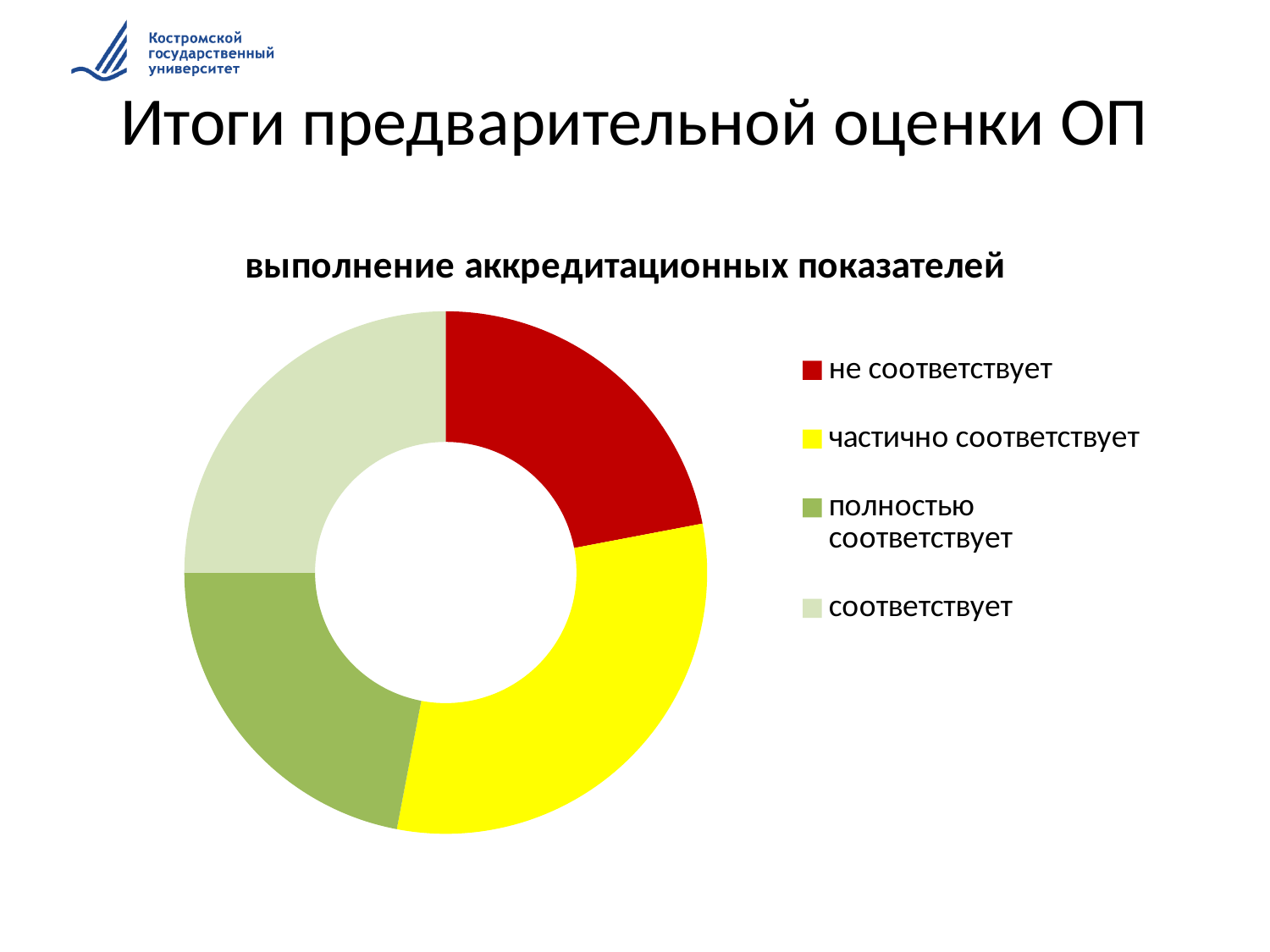
How many categories (slices) does the chart have? 4 Which slice is larger: "частично соответствует" or "соответствует"? частично соответствует What kind of chart is shown on the slide? doughnut (pie) chart Which slice is larger: "частично соответствует" or "не соответствует"? частично соответствует What colour represents "не соответствует" in the chart? red How many entries does the legend list? 4 Which category has the largest slice of the chart? частично соответствует What is the title of the chart? выполнение аккредитационных показателей